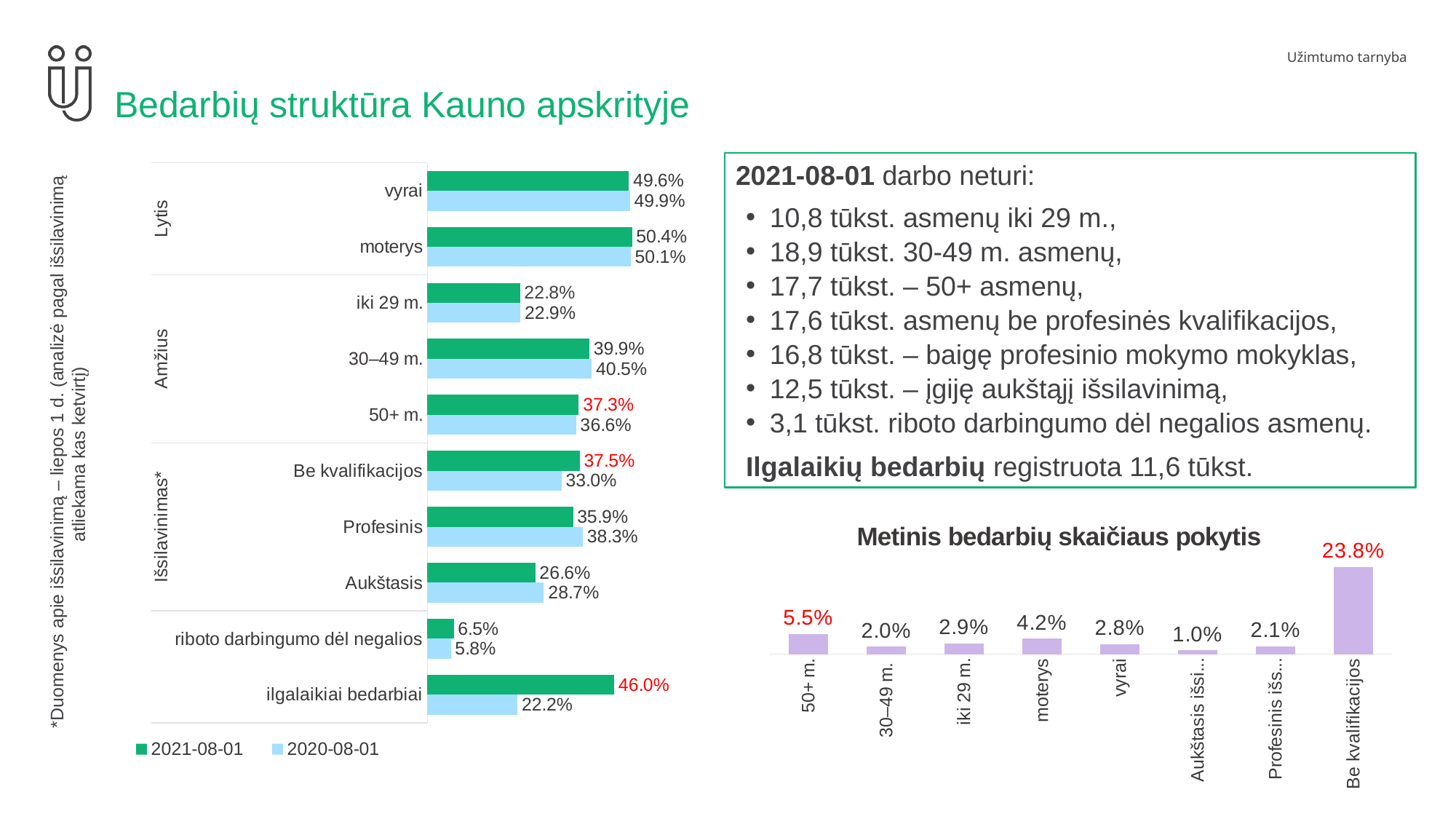
In the left bar chart, what is the 2020-08-01 value for Profesinis? 38.3% How many categories are shown in the chart 'Metinis bedarbių skaičiaus pokytis'? 8 In the left bar chart, what is the 2021-08-01 value for ilgalaikiai bedarbiai? 46.0% In the left bar chart, is the 2021-08-01 value for Be kvalifikacijos larger or smaller than the 2020-08-01 value? larger How many series does the legend of the left bar chart list? 2 In the chart 'Metinis bedarbių skaičiaus pokytis', which category has the lowest value? Aukštasis išsi... In the chart 'Metinis bedarbių skaičiaus pokytis', which category has the highest value? Be kvalifikacijos In the left bar chart, which category has the lowest 2021-08-01 value? riboto darbingumo dėl negalios In the left bar chart, what is the 2021-08-01 value for 50+ m.? 37.3% In the left bar chart, what is the difference between the 2021-08-01 and 2020-08-01 values for ilgalaikiai bedarbiai? 23.8 percentage points What kind of chart is 'Metinis bedarbių skaičiaus pokytis'? bar chart In the chart 'Metinis bedarbių skaičiaus pokytis', what is the value for moterys? 4.2%